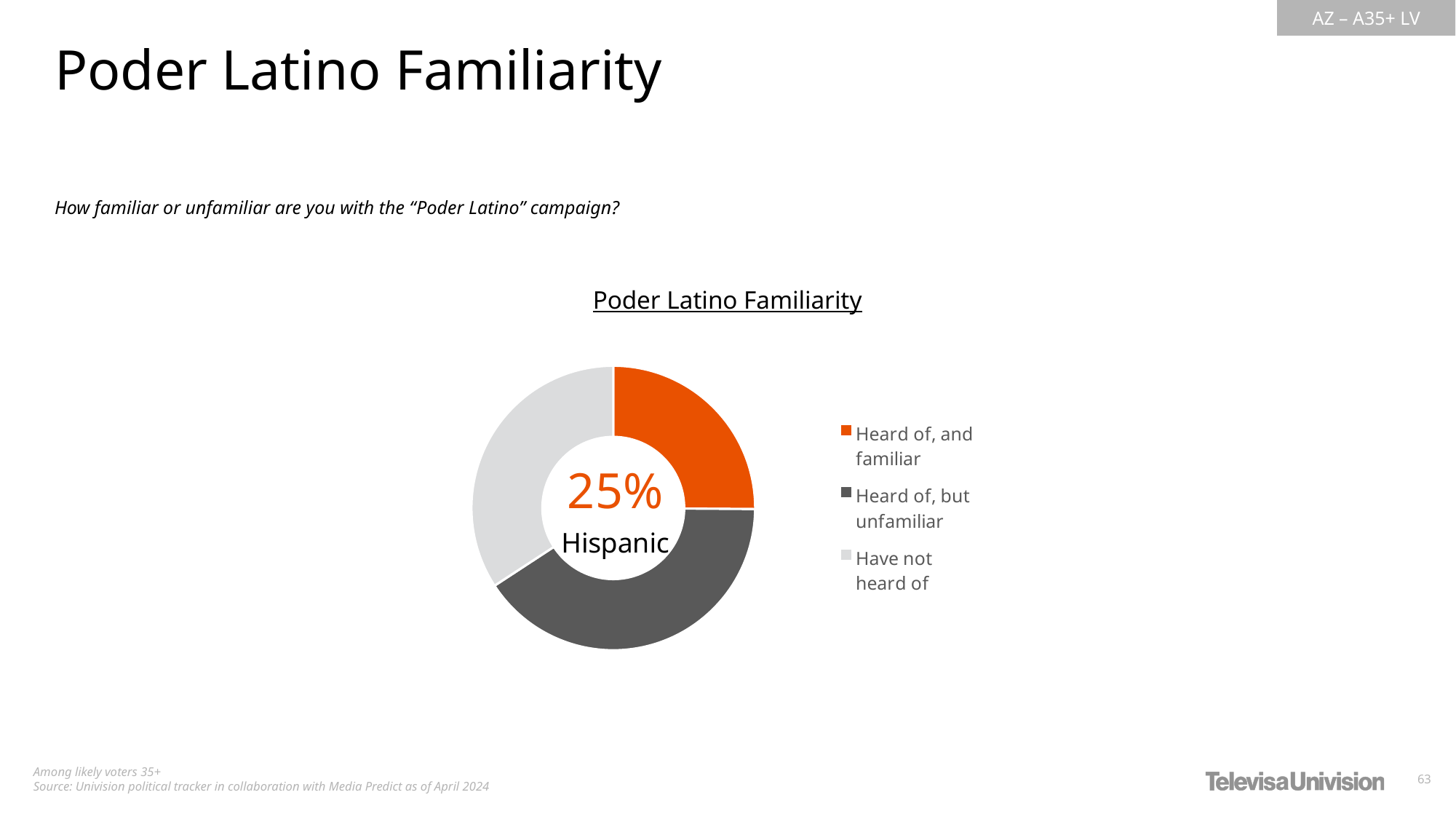
Which group label is printed in the centre of the donut chart below the percentage? Hispanic What is the title of the chart? Poder Latino Familiarity Which slice is larger: 'Have not heard of' or 'Heard of, and familiar'? Have not heard of What kind of chart is shown on the slide? Pie chart (donut) Which category is the largest slice of the donut chart? Heard of, but unfamiliar How many categories does the chart's legend list? 3 Which category is the smallest slice of the donut chart? Heard of, and familiar What share of Hispanic respondents have heard of, and are familiar with, the Poder Latino campaign? 25% What percentage is printed in the centre of the donut chart? 25% How many slices does the donut chart have? 3 Which colour represents the 'Have not heard of' category in the chart? Light gray Which slice is larger: 'Heard of, but unfamiliar' or 'Heard of, and familiar'? Heard of, but unfamiliar